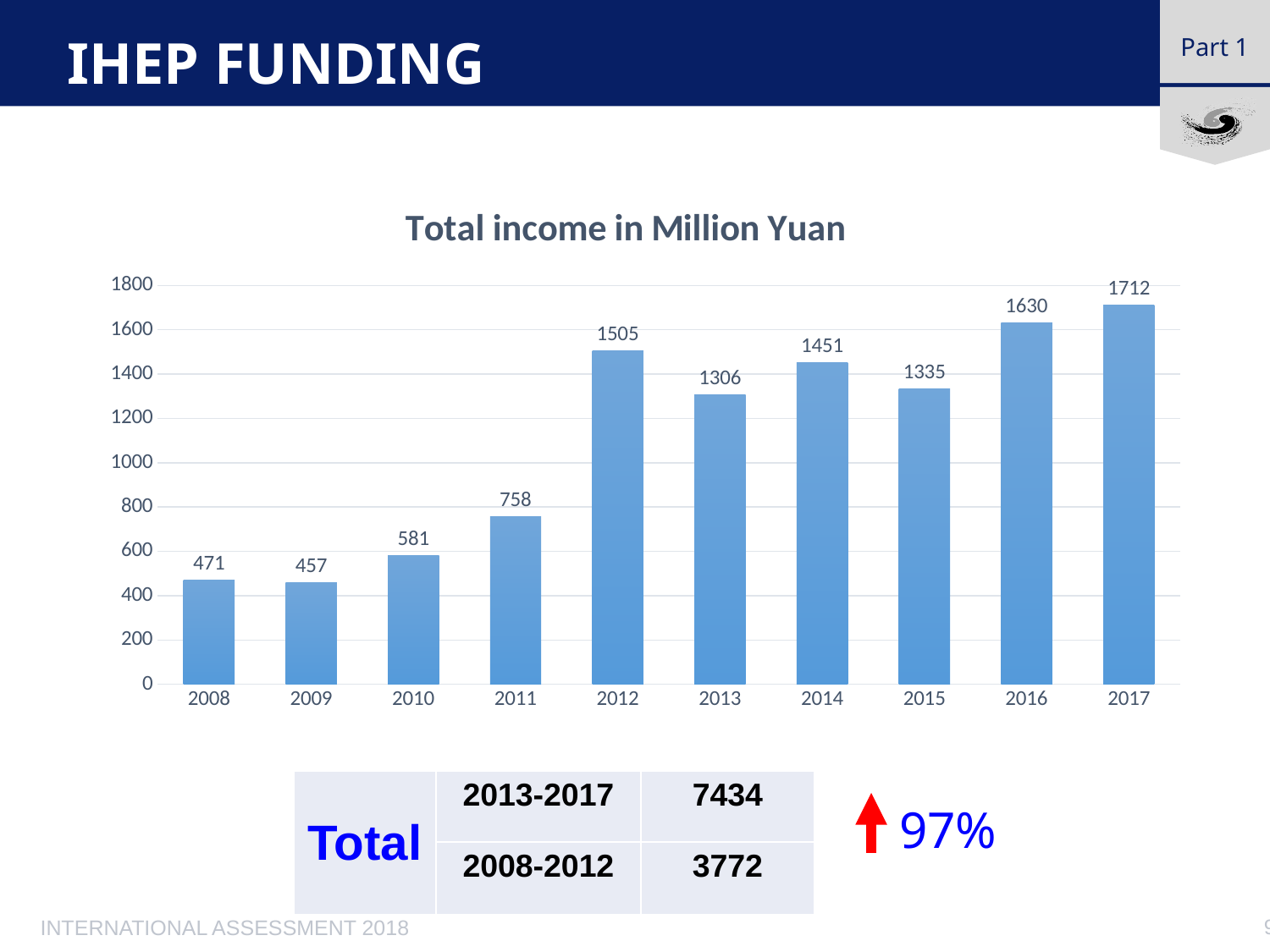
What is the total income in 2012? 1505 What is the total income in 2009? 457 Does the total income generally rise or fall from 2008 to 2017? rise Is the value for 2011 greater or less than 800? less What kind of chart is shown on the slide? bar chart What is the difference in total income between 2017 and 2008? 1241 What is the difference in total income between 2012 and 2013? 199 What is the title of the chart? Total income in Million Yuan Which year has the highest total income? 2017 How many years are shown on the chart? 10 Which year has the lowest total income? 2009 Which year has a larger total income, 2014 or 2015? 2014